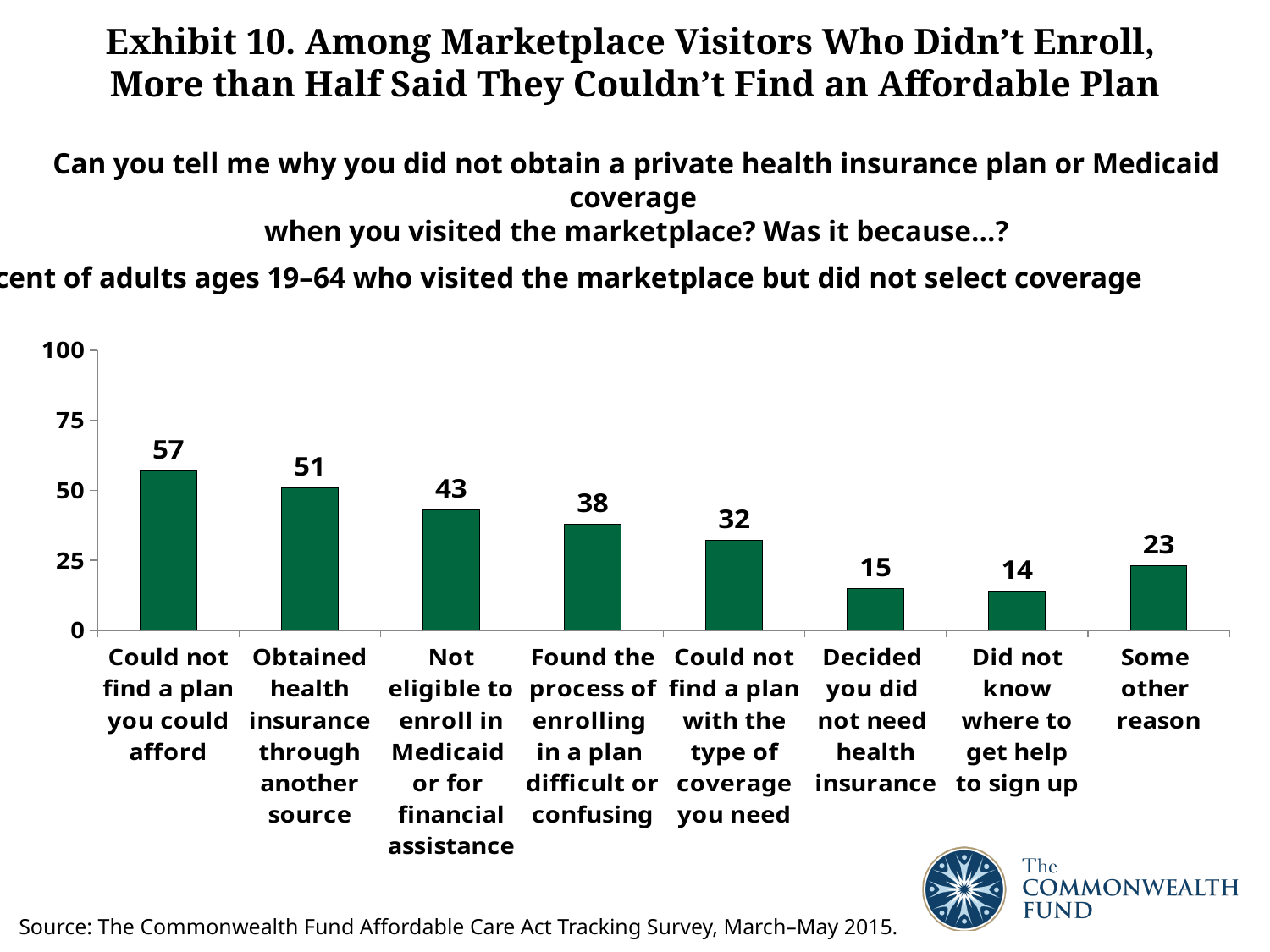
What is the value for 'Did not know where to get help to sign up'? 14 What kind of chart is shown on the slide? Bar chart What is the difference between the values for 'Could not find a plan you could afford' and 'Some other reason'? 34 What is the maximum value shown on the vertical axis? 100 Which is larger: the value for 'Found the process of enrolling in a plan difficult or confusing' or the value for 'Could not find a plan with the type of coverage you need'? Found the process of enrolling in a plan difficult or confusing What is the value for 'Obtained health insurance through another source'? 51 Which reason has the highest value in the chart? Could not find a plan you could afford Which reason has the lowest value in the chart? Did not know where to get help to sign up How many reasons (categories) are shown in the chart? 8 Is the value for 'Not eligible to enroll in Medicaid or for financial assistance' greater or less than 50? less What percent of adults who visited the marketplace but did not select coverage said they could not find a plan they could afford? 57 What is the difference between the values for 'Decided you did not need health insurance' and 'Did not know where to get help to sign up'? 1